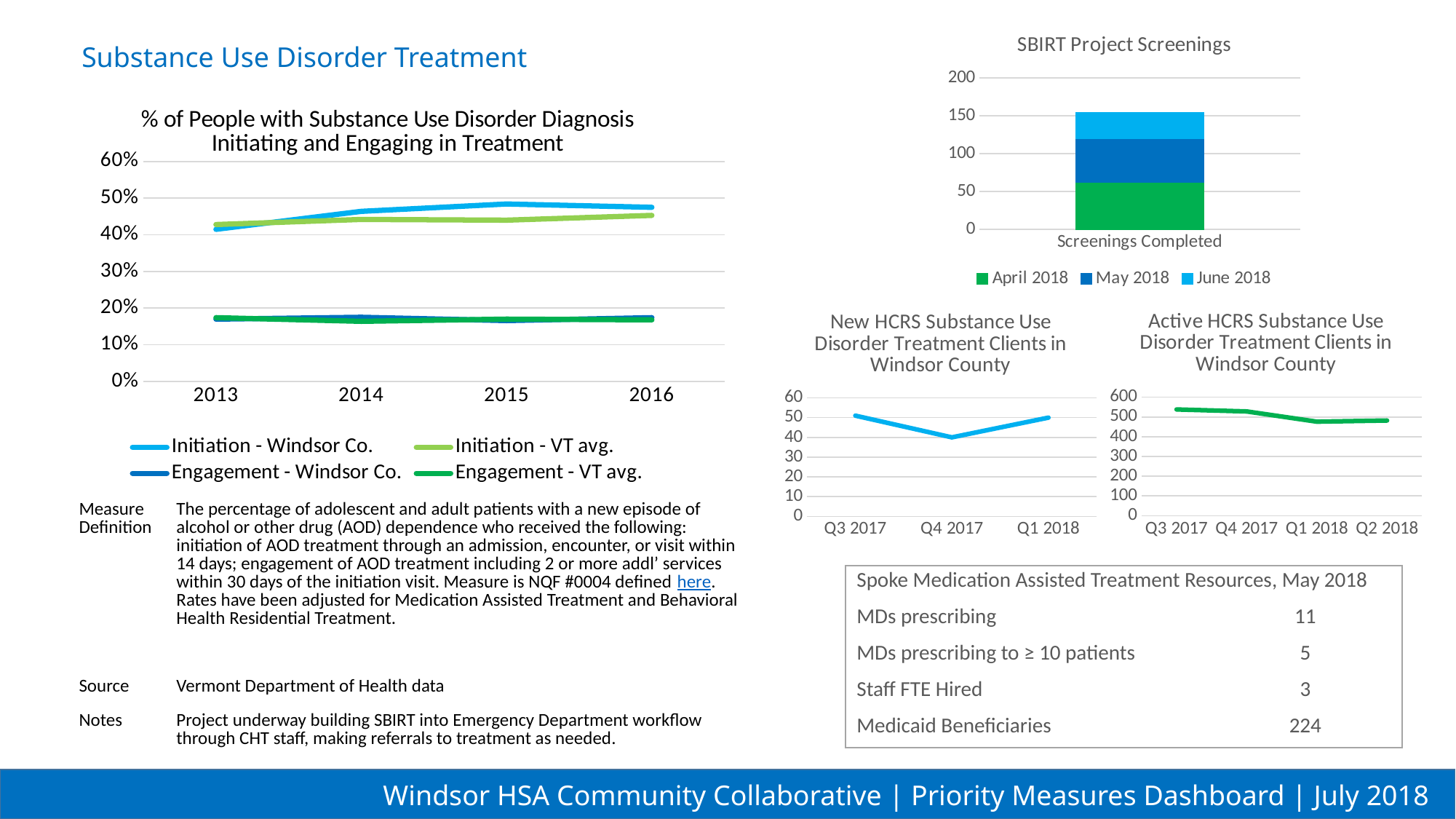
In the '% of People with Substance Use Disorder Diagnosis Initiating and Engaging in Treatment' chart, which is larger in 2015: Initiation - Windsor Co. or Engagement - Windsor Co.? Initiation - Windsor Co. In the 'SBIRT Project Screenings' chart, is the total height of the Screenings Completed bar greater or less than 100? greater In the '% of People with Substance Use Disorder Diagnosis Initiating and Engaging in Treatment' chart, is the value for Initiation - Windsor Co. in 2015 greater or less than 40%? greater What kind of chart is the 'SBIRT Project Screenings' chart? stacked bar chart What kind of chart is the '% of People with Substance Use Disorder Diagnosis Initiating and Engaging in Treatment' chart? line chart In the 'New HCRS Substance Use Disorder Treatment Clients in Windsor County' chart, which quarter has the lowest value? Q4 2017 How many data points are plotted in the 'New HCRS Substance Use Disorder Treatment Clients in Windsor County' chart? 3 In the '% of People with Substance Use Disorder Diagnosis Initiating and Engaging in Treatment' chart, is the value for Engagement - Windsor Co. in 2016 greater or less than 20%? less How many series does the legend of the 'SBIRT Project Screenings' chart list? 3 How many series does the legend of the '% of People with Substance Use Disorder Diagnosis Initiating and Engaging in Treatment' chart list? 4 In the 'Active HCRS Substance Use Disorder Treatment Clients in Windsor County' chart, do the values generally rise or fall from Q3 2017 to Q2 2018? fall